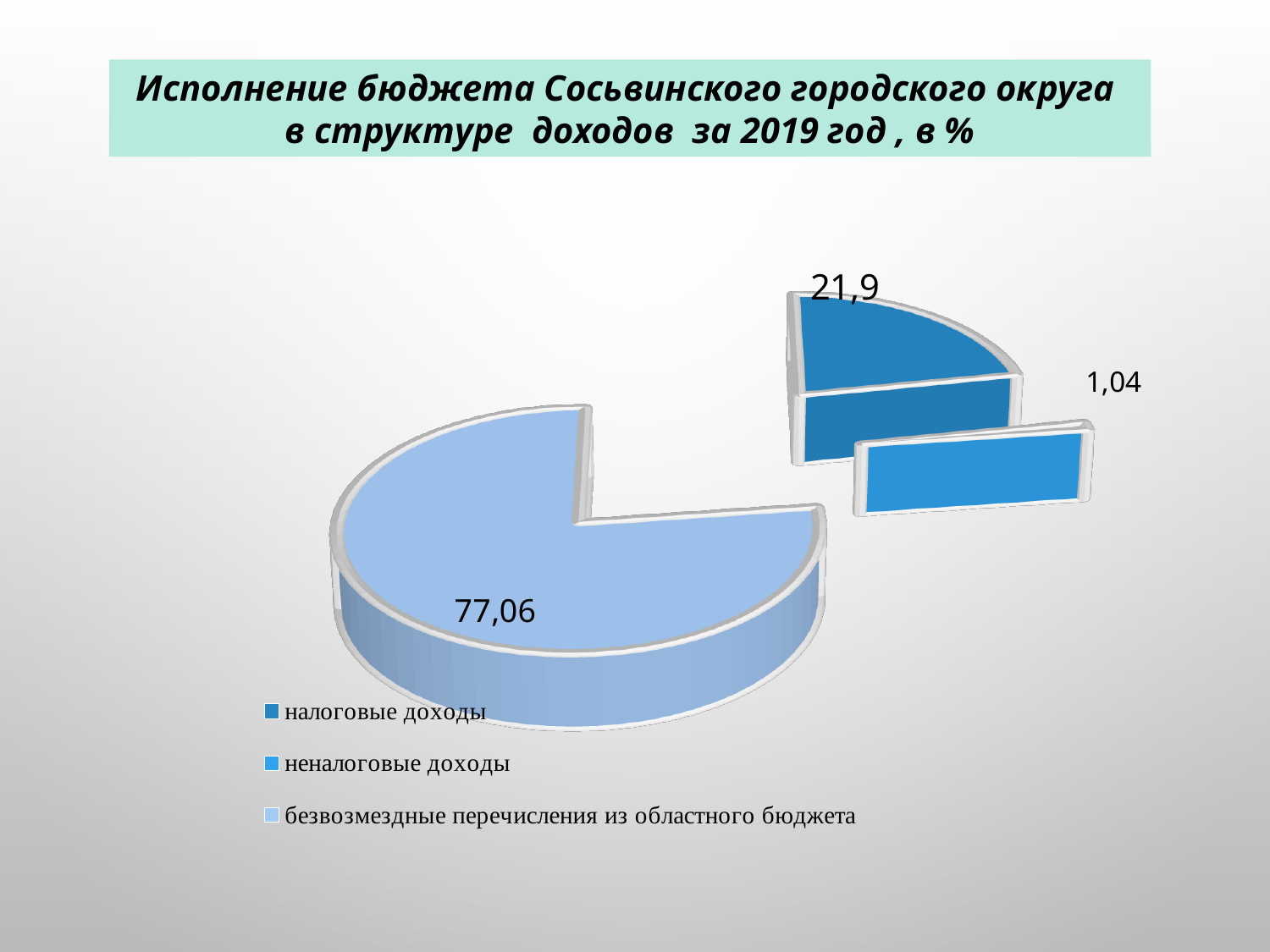
Which category has the largest slice of the pie? безвозмездные перечисления из областного бюджета What kind of chart is shown on the slide? pie chart How many categories does the pie chart have? 3 Which is larger, налоговые доходы or неналоговые доходы? налоговые доходы What is the value for налоговые доходы? 21,9 Which category has the smallest slice of the pie? неналоговые доходы What is the difference between the values for налоговые доходы and неналоговые доходы? 20,86 What is the value for неналоговые доходы? 1,04 What is the value for безвозмездные перечисления из областного бюджета? 77,06 What is the difference between the values for безвозмездные перечисления из областного бюджета and налоговые доходы? 55,16 Which year does the chart title say the data is for? 2019 What share of the pie does налоговые доходы represent, in %? 21,9